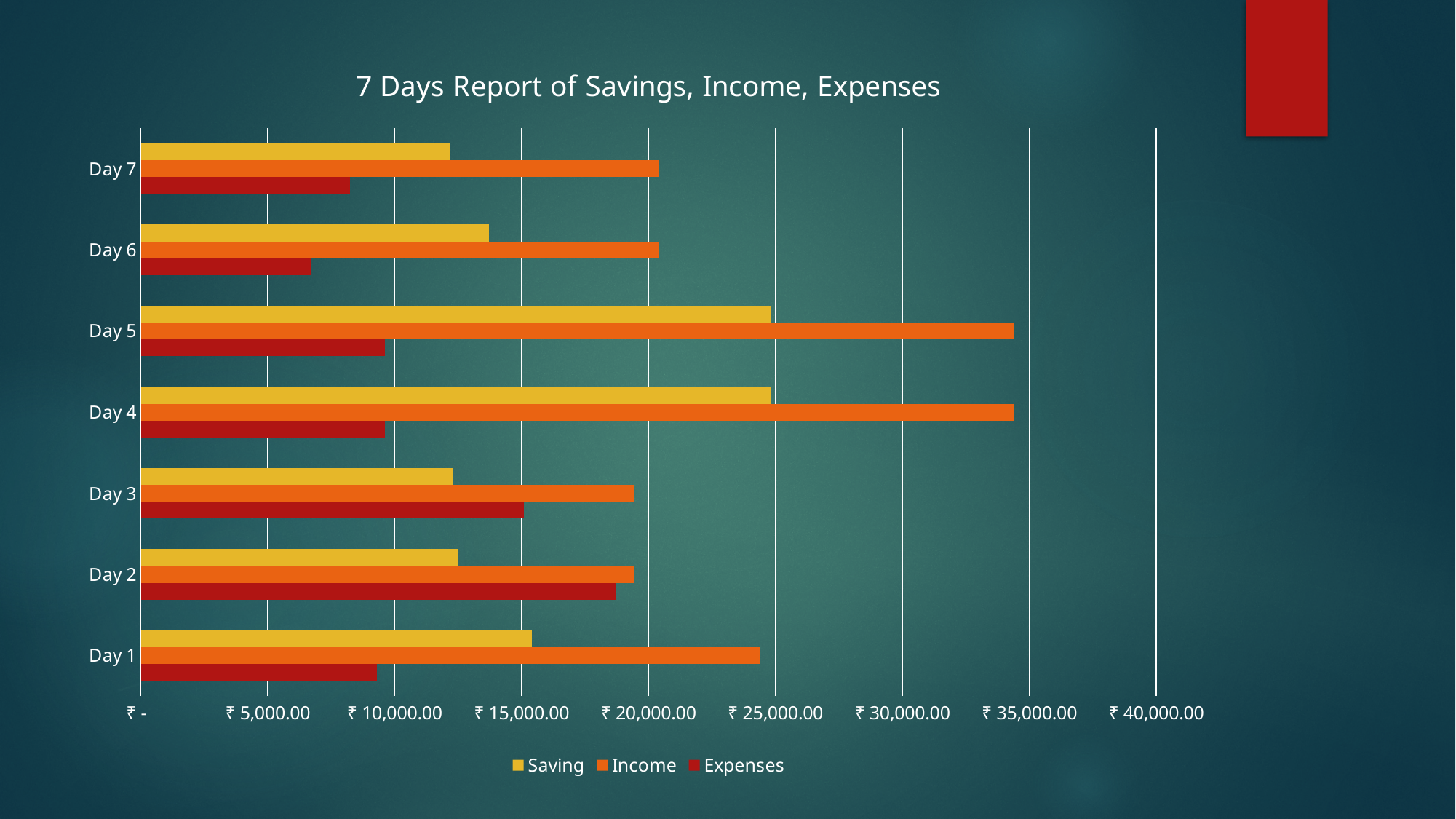
Is the Expenses value for Day 6 greater or less than ₹ 10,000.00? less Which is larger, the Income for Day 1 or the Income for Day 7? Day 1 Is the Income value for Day 5 greater or less than ₹ 30,000.00? greater What kind of chart is shown on the slide? Bar chart Which is larger, the Expenses for Day 2 or the Expenses for Day 3? Day 2 What is the title of the chart? 7 Days Report of Savings, Income, Expenses Is the Saving value for Day 7 greater or less than ₹ 10,000.00? greater Which day has the highest Expenses? Day 2 How many series does the legend list? 3 How many days are shown on the chart? 7 Which day has the lowest Expenses? Day 6